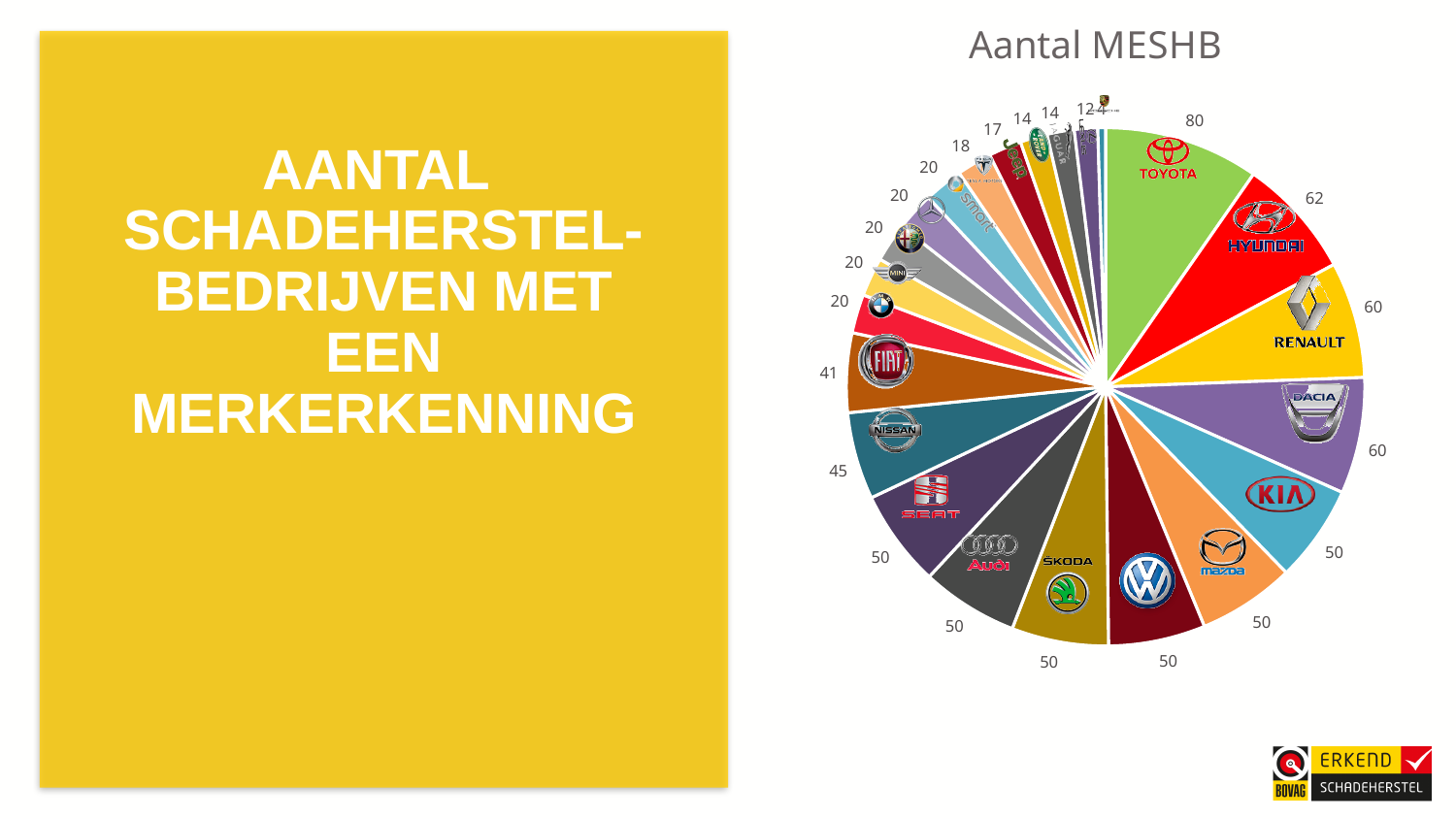
What is the value for Renault in the pie chart? 60 Which brand has the largest slice in the pie chart? Toyota What is the value for Toyota in the pie chart? 80 What is the difference between the values for Toyota and Hyundai? 18 What is the value for Hyundai in the pie chart? 62 What is the value for Jeep in the pie chart? 17 Which has a larger value, Nissan or Fiat? Nissan What is the value for Kia in the pie chart? 50 What is the value for Fiat in the pie chart? 41 What kind of chart is shown on the slide? pie chart What is the value for Nissan in the pie chart? 45 What is the title of the chart? Aantal MESHB